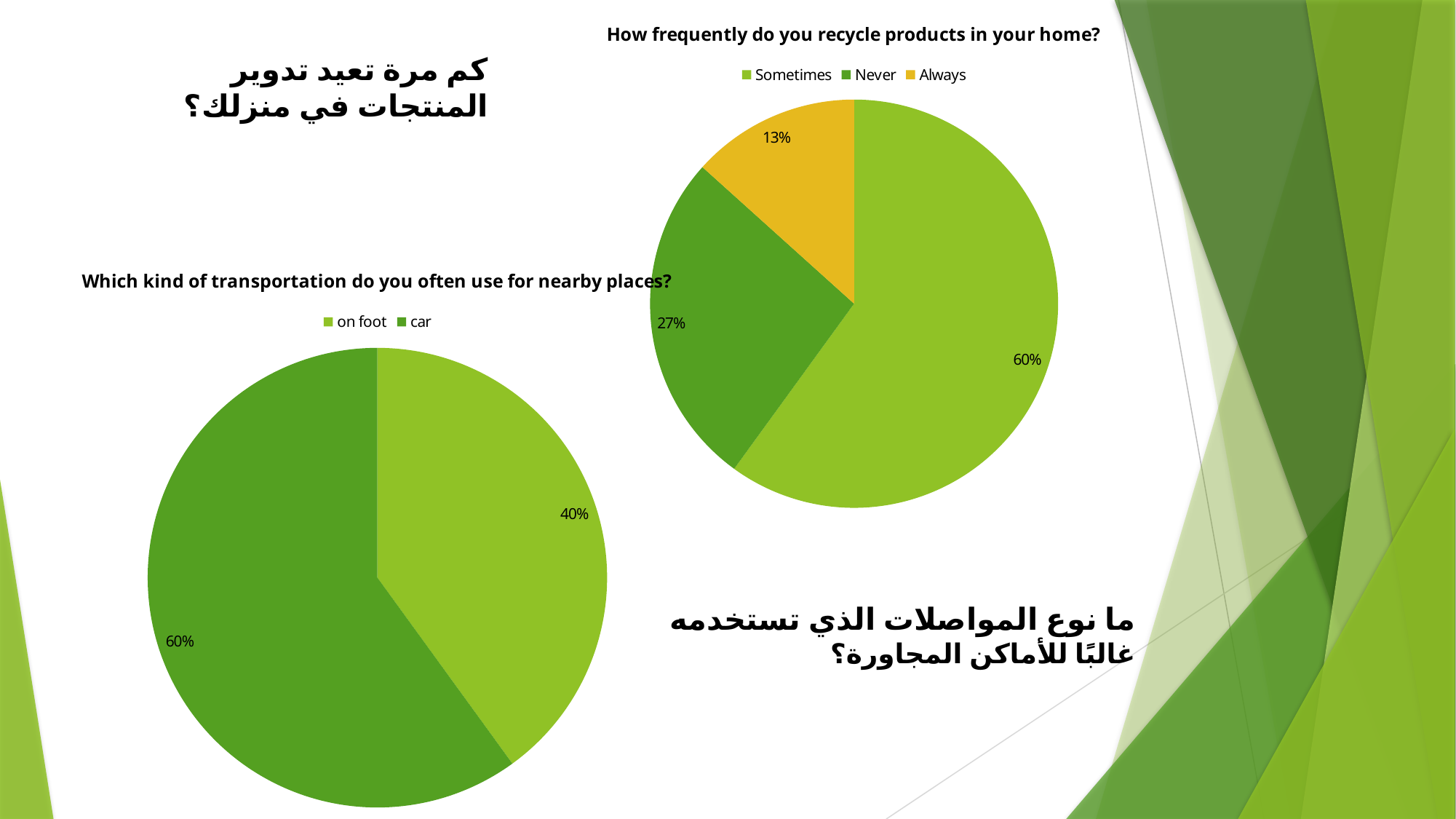
In the chart titled "Which kind of transportation do you often use for nearby places?", what is the difference in percentage points between car and on foot? 20 In the chart titled "Which kind of transportation do you often use for nearby places?", what share of the pie is labelled car? 60% In the chart titled "How frequently do you recycle products in your home?", what is the difference in percentage points between Sometimes and Never? 33 What kind of chart is the one titled "Which kind of transportation do you often use for nearby places?"? Pie chart In the chart titled "Which kind of transportation do you often use for nearby places?", which category is larger, on foot or car? car In the chart titled "How frequently do you recycle products in your home?", how many categories does the legend list? 3 In the chart titled "How frequently do you recycle products in your home?", which category has the largest slice? Sometimes In the chart titled "How frequently do you recycle products in your home?", what share of the pie is labelled Never? 27% In the chart titled "How frequently do you recycle products in your home?", what share of the pie is labelled Sometimes? 60% In the chart titled "How frequently do you recycle products in your home?", what share of the pie is labelled Always? 13% In the chart titled "How frequently do you recycle products in your home?", which category has the smallest slice? Always In the chart titled "Which kind of transportation do you often use for nearby places?", what share of the pie is labelled on foot? 40%